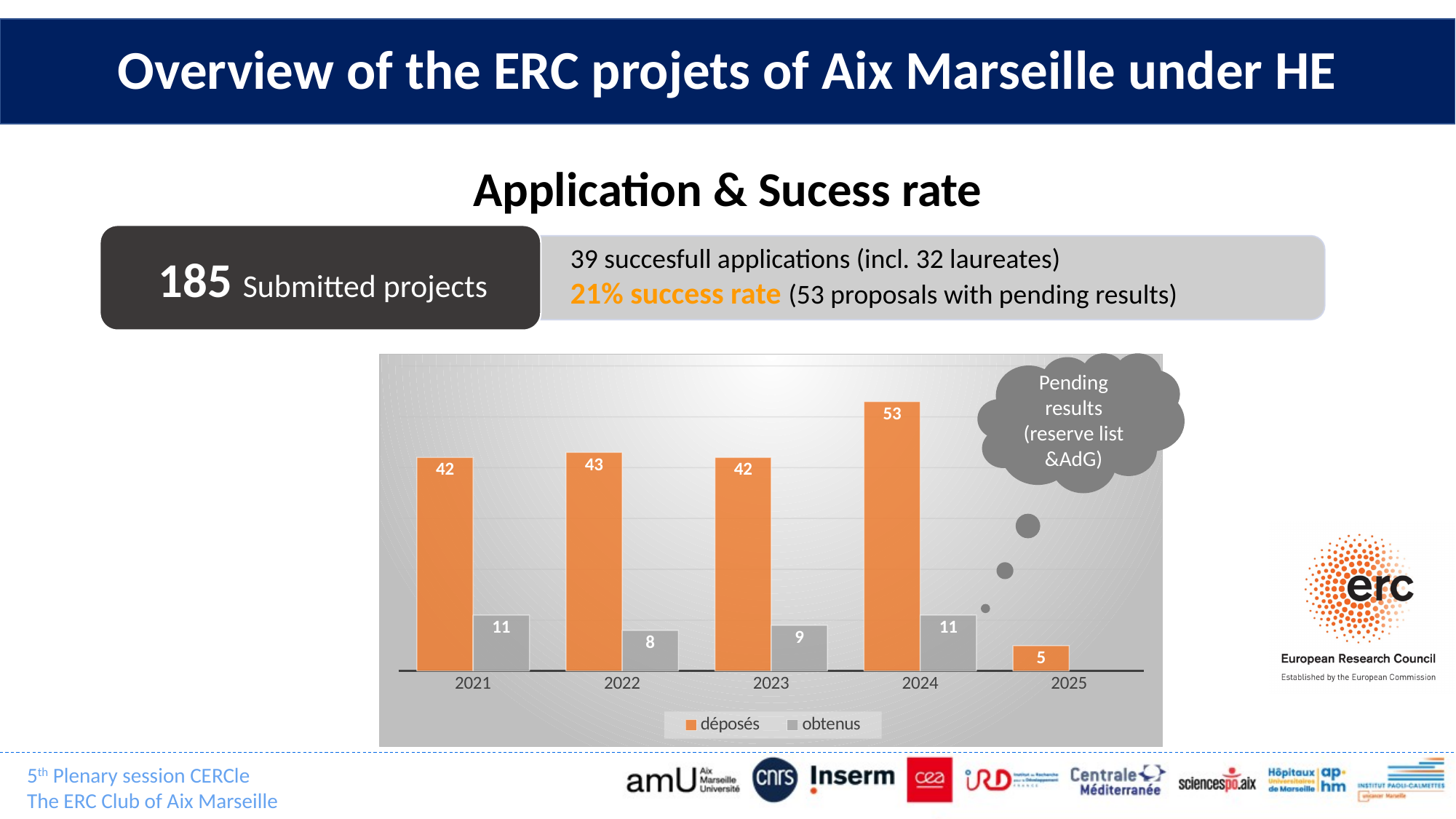
What colour are the déposés bars? orange Which is larger, obtenus in 2021 or obtenus in 2023? obtenus in 2021 What is the difference between déposés and obtenus in 2023? 33 What is the value of déposés for 2024? 53 What is the difference between déposés in 2024 and déposés in 2021? 11 What is the value of déposés for 2025? 5 How many series does the legend list? 2 Which year has the lowest value for obtenus among the years where it is shown? 2022 What is the value of obtenus for 2022? 8 Which year has the highest value for déposés? 2024 How many years are shown on the x axis? 5 What kind of chart is shown? bar chart